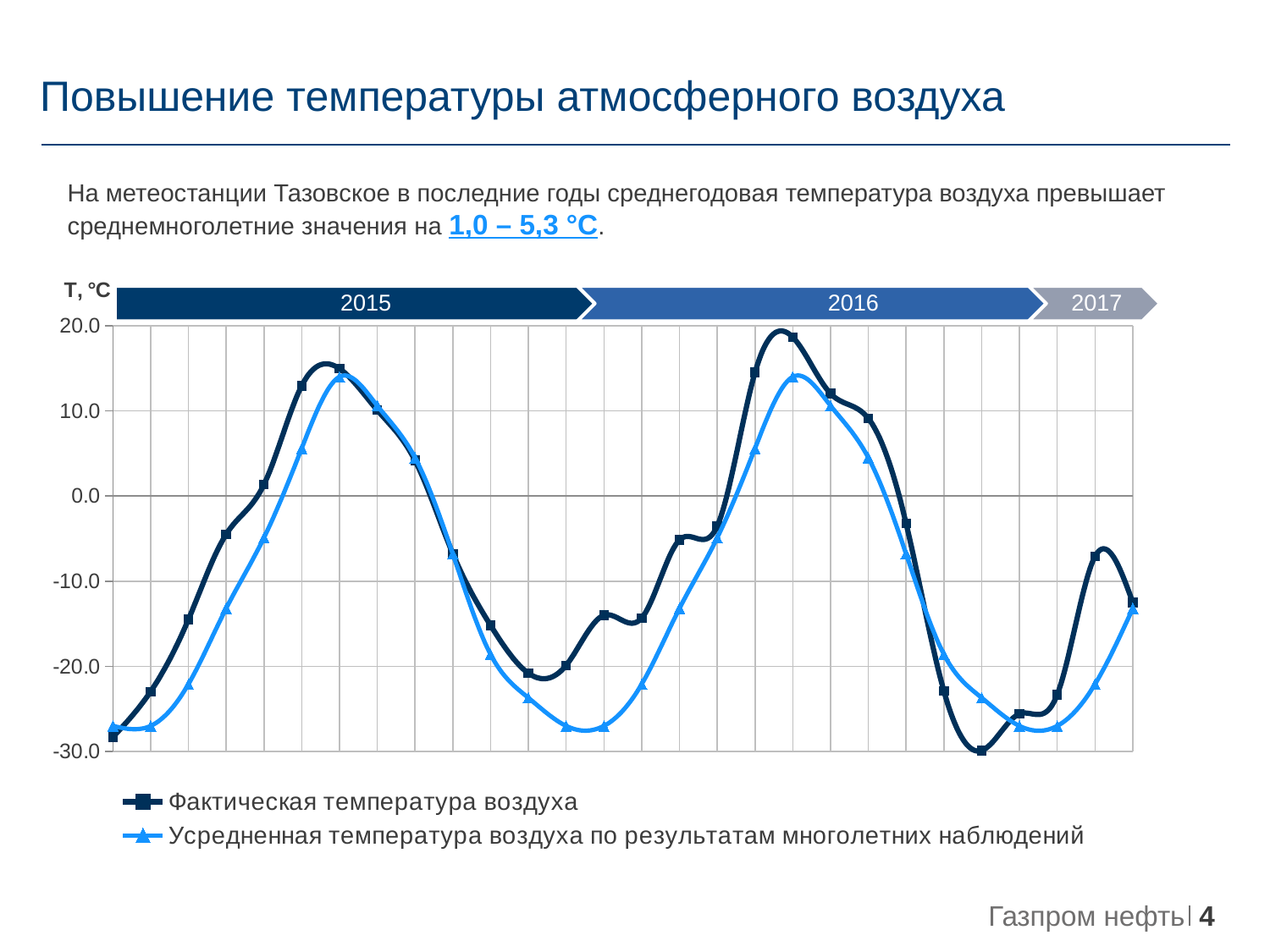
In the 2017 portion of the chart, does the averaged temperature (Усредненная температура воздуха) rise or fall along the x axis? rise How many series does the chart legend list? 2 Which series reaches the higher peak in 2016, the actual temperature or the averaged temperature? Фактическая температура воздуха Is the peak of the averaged temperature (Усредненная температура воздуха) in 2016 greater or less than 20.0? less Is the lowest value of the actual air temperature (Фактическая температура воздуха) in 2016 greater or less than -20.0? less What label is shown on the vertical axis of the chart? T, °C What are the two series named in the legend? Фактическая температура воздуха; Усредненная температура воздуха по результатам многолетних наблюдений Is the peak of the averaged temperature (Усредненная температура воздуха) in 2015 greater or less than 10.0? greater How many year bands are shown above the chart? 3 Which series reaches the lower minimum in 2016, the actual temperature or the averaged temperature? Фактическая температура воздуха What kind of chart is shown on the slide? Line chart